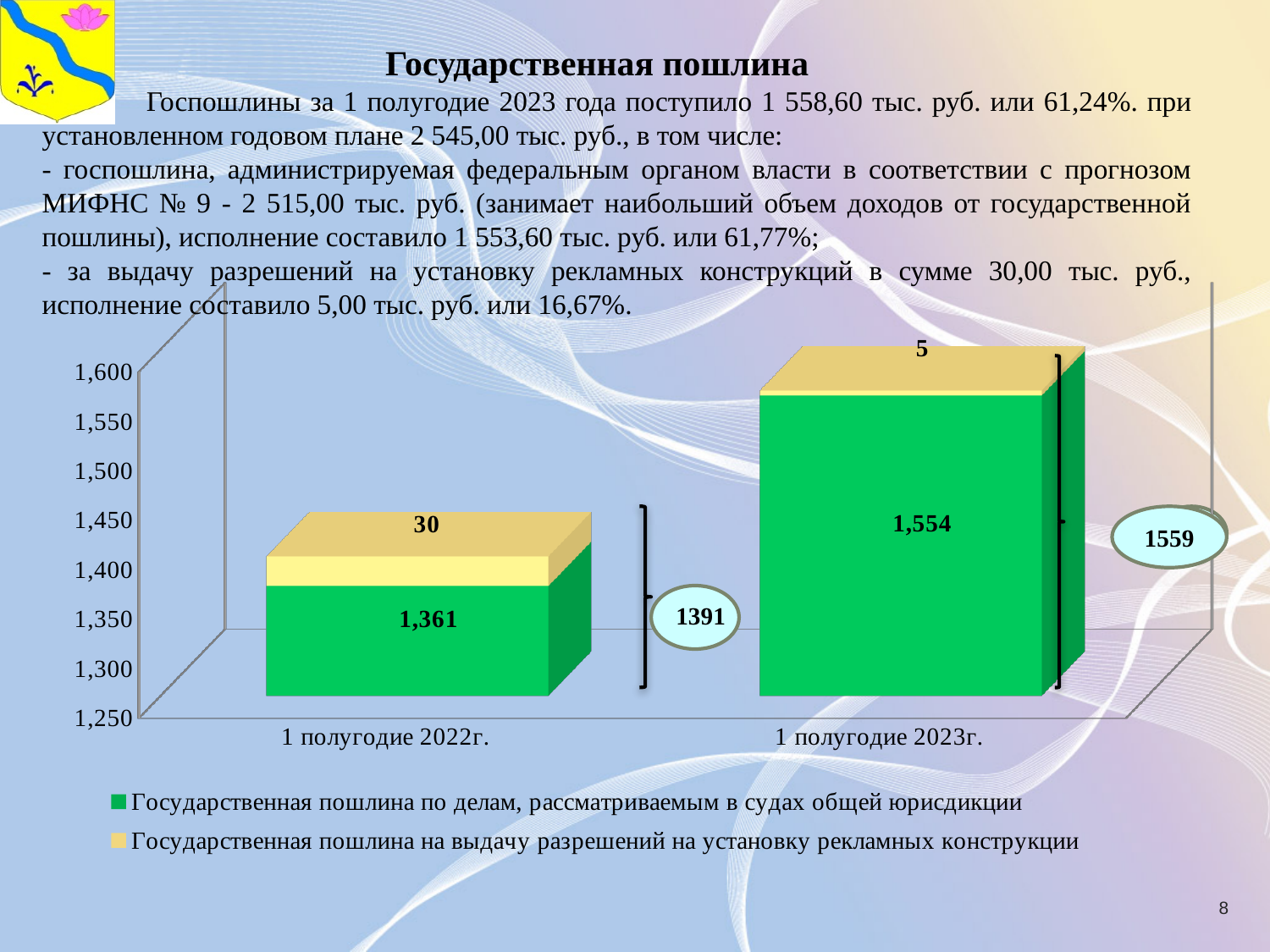
What is the value of the yellow series for 1 полугодие 2023г.? 5 What is the value of the green series for 1 полугодие 2022г.? 1,361 How many series does the legend list? 2 What is the value of the green series (Государственная пошлина по делам, рассматриваемым в судах общей юрисдикции) for 1 полугодие 2023г.? 1,554 What is the total of the stacked bar for 1 полугодие 2022г.? 1391 What is the total of the stacked bar for 1 полугодие 2023г.? 1559 Which period has the higher value for the green series? 1 полугодие 2023г. What is the value of the yellow series (Государственная пошлина на выдачу разрешений на установку рекламных конструкции) for 1 полугодие 2022г.? 30 What kind of chart is shown on the slide? Stacked bar chart What is the difference between the green series values for 1 полугодие 2023г. and 1 полугодие 2022г.? 193 How many categories are shown on the x axis? 2 Which period has the lower value for the yellow series? 1 полугодие 2023г.